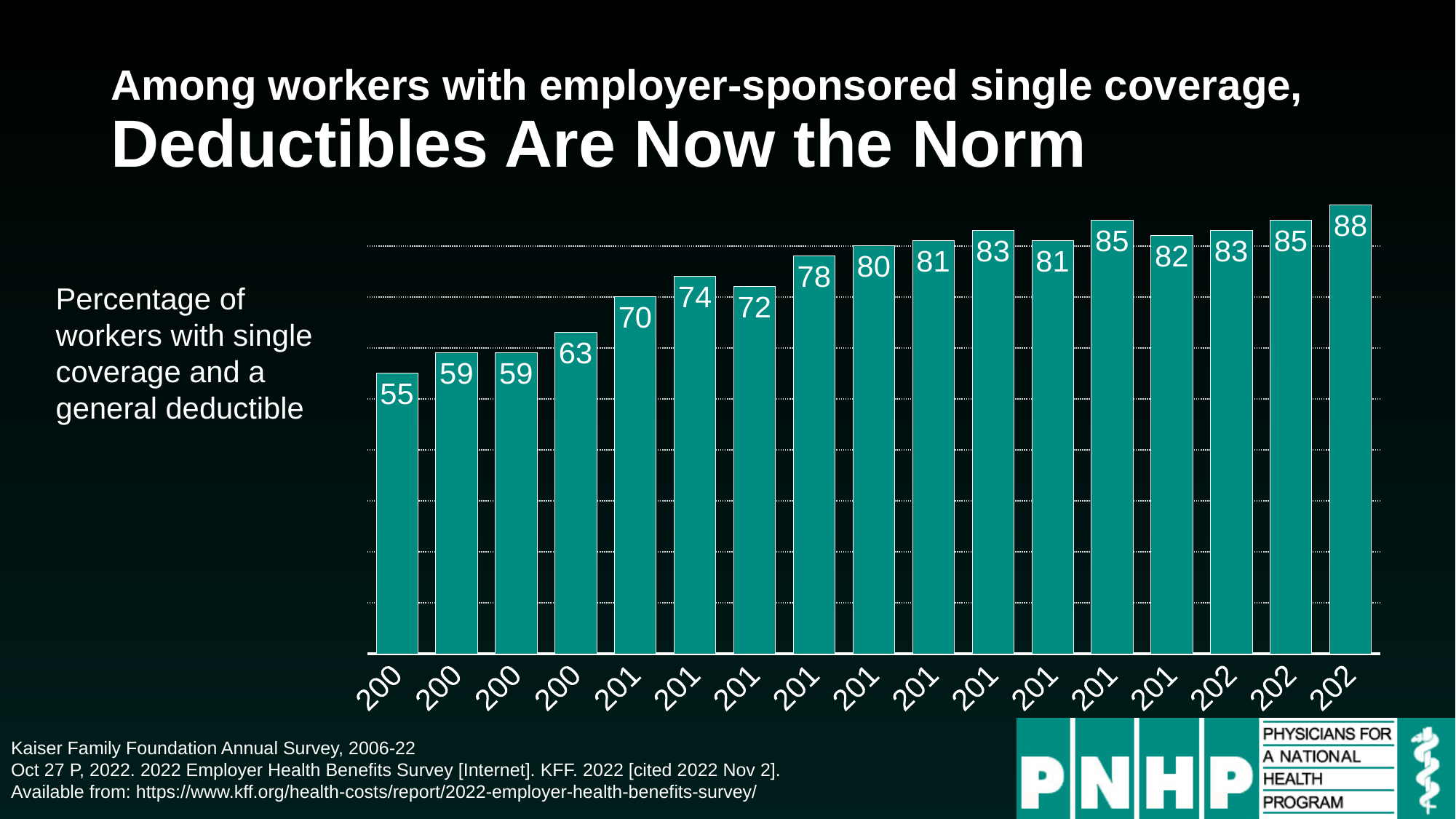
Which bar has the lowest value in the chart? the first (leftmost) bar, 55 Which bar has the highest value in the chart? the last (rightmost) bar, 88 Which is larger: the value of the fifth bar from the left or the value of the seventh bar from the left? the seventh bar (72) How many bars in the chart have a value of 59? 2 What is the value shown on the first (leftmost) bar of the chart? 55 According to the text beside the chart, what do the bars represent? Percentage of workers with single coverage and a general deductible How many bars are plotted in the chart? 17 Do the values generally rise or fall from left to right across the chart? rise What is the value shown on the fourth bar from the left? 63 What is the difference between the value of the last bar and the value of the first bar? 33 What is the value shown on the last (rightmost) bar of the chart? 88 What kind of chart is shown on the slide? bar chart